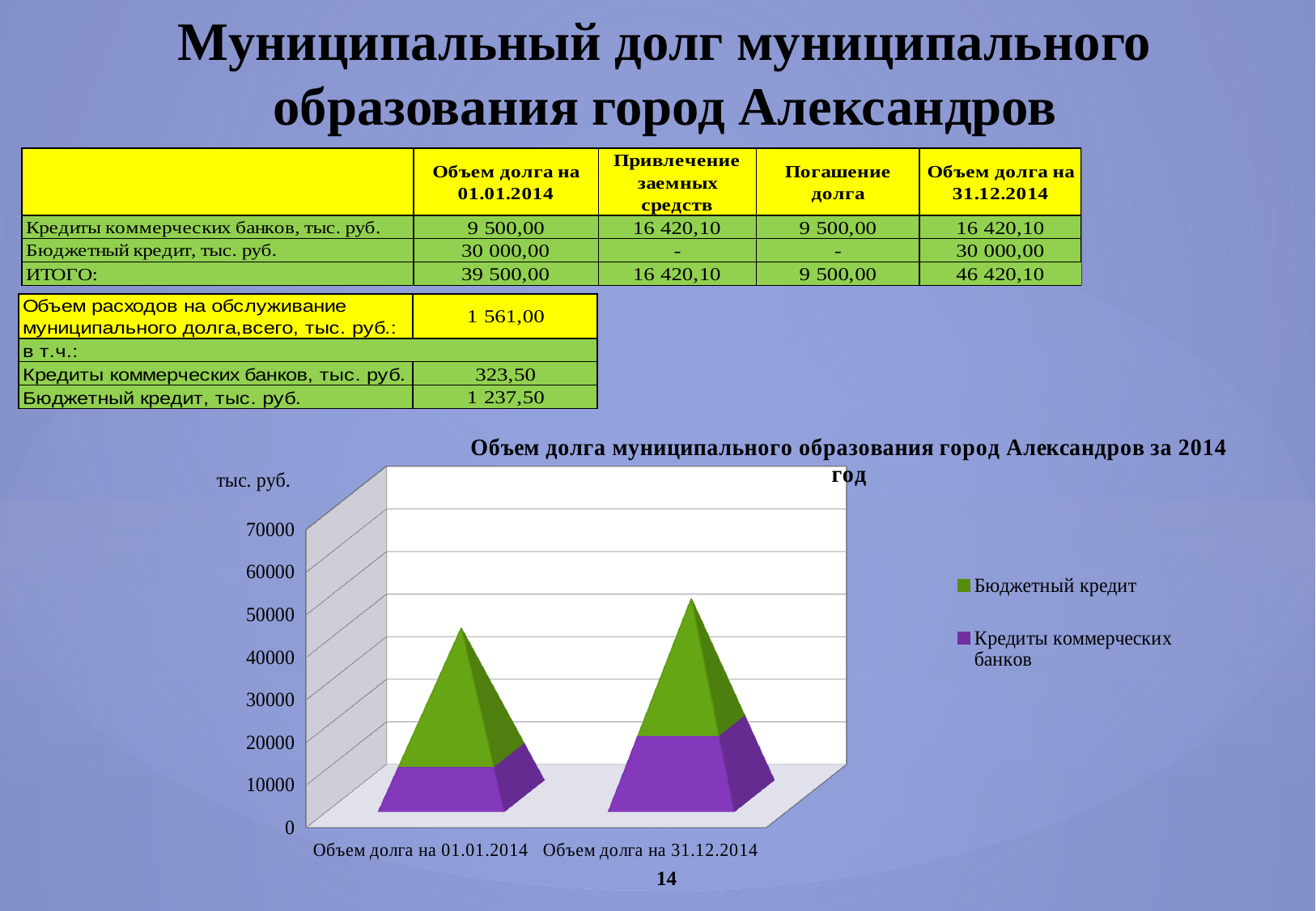
Is the total stacked value for 'Объем долга на 31.12.2014' greater or less than 40000? greater Is the 'Кредиты коммерческих банков' value for 'Объем долга на 31.12.2014' greater or less than 30000? less What kind of chart is shown on the slide? bar chart Which series in the chart is shown in purple? Кредиты коммерческих банков Which category has the larger total debt in the chart, 'Объем долга на 01.01.2014' or 'Объем долга на 31.12.2014'? Объем долга на 31.12.2014 What is the title of the chart? Объем долга муниципального образования город Александров за 2014 год Is the 'Кредиты коммерческих банков' value for 'Объем долга на 01.01.2014' greater or less than 20000? less Does the total debt rise or fall from 'Объем долга на 01.01.2014' to 'Объем долга на 31.12.2014'? rise What unit is written above the vertical axis of the chart? тыс. руб. How many categories are shown on the x axis of the chart? 2 How many series does the chart legend list? 2